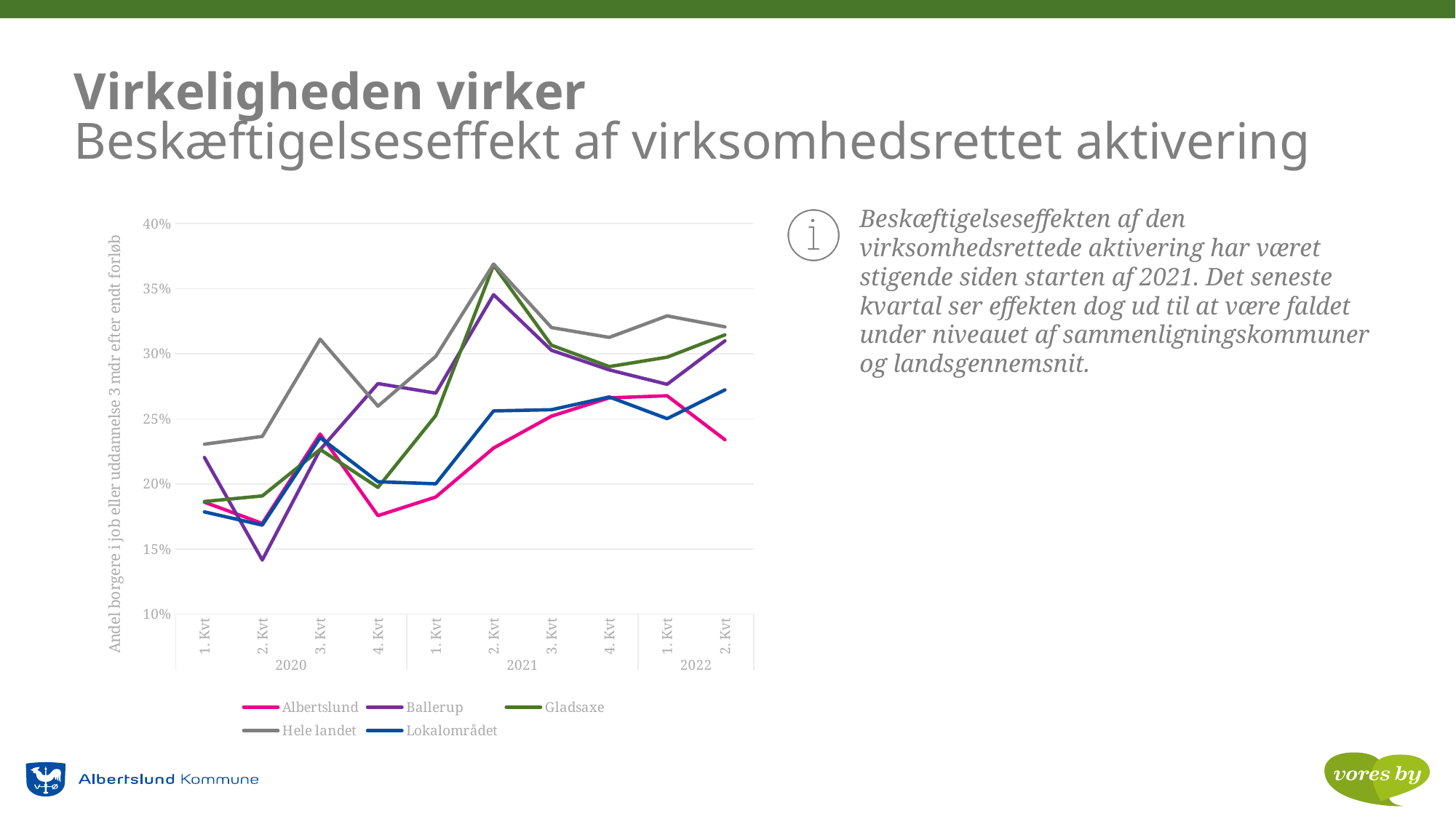
Is the value for Ballerup in 2. Kvt 2020 greater or less than 15%? less Is the value for Hele landet in 2. Kvt 2021 greater or less than 35%? greater Is the value for Albertslund in 4. Kvt 2020 greater or less than 20%? less Which series has the lowest value in 2. Kvt 2020? Ballerup Which series has the highest value in 1. Kvt 2022? Hele landet What kind of chart is shown on the slide? line chart In 2. Kvt 2022, which is larger: the value for Hele landet or the value for Albertslund? Hele landet Does the Albertslund line rise or fall from 1. Kvt 2021 to 4. Kvt 2021? rise How many series does the chart legend list? 5 How many quarters are plotted along the x axis of the chart? 10